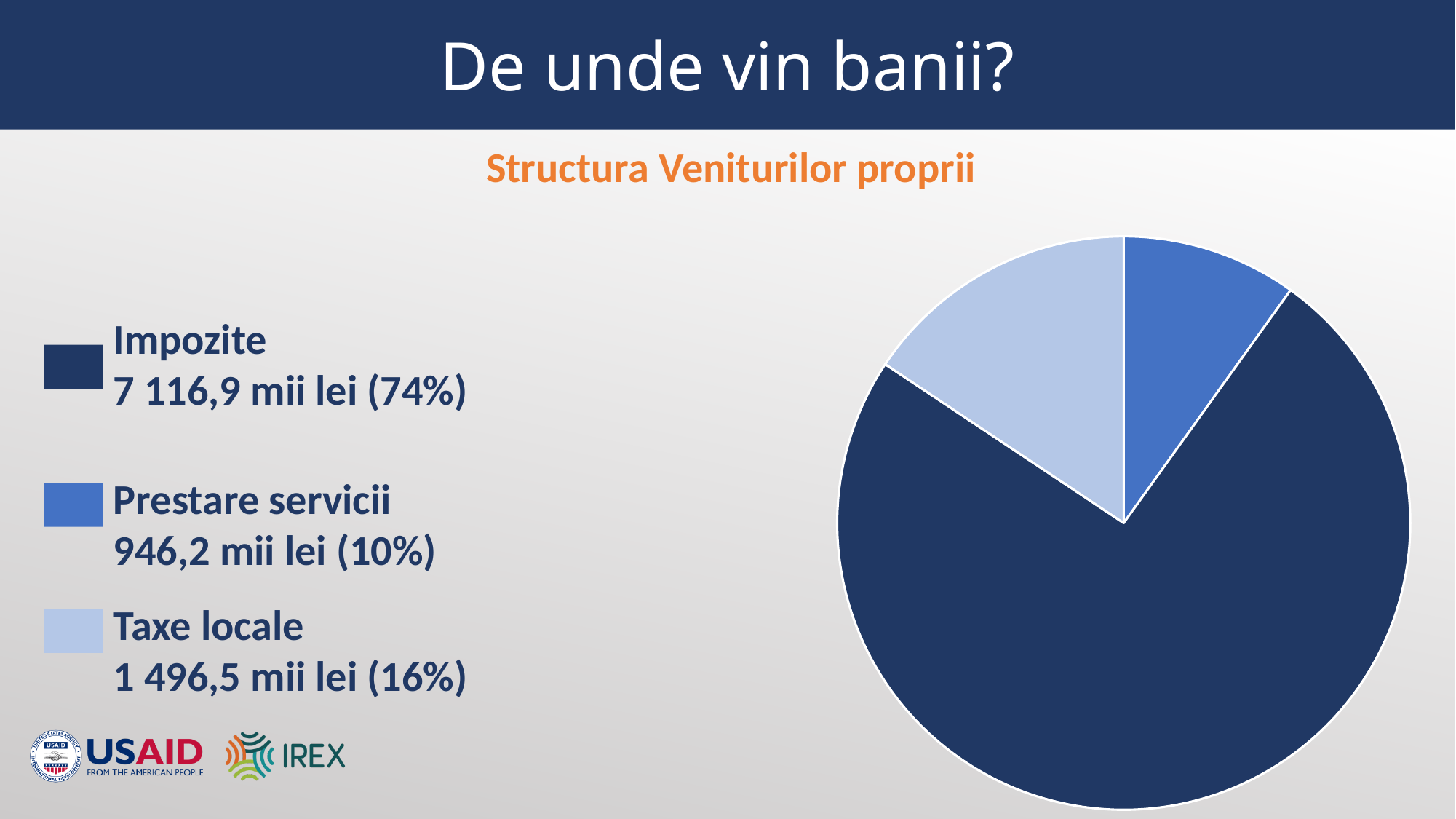
Which category has the smallest slice of the pie? Prestare servicii What share of the pie does Impozite represent? 74% How many categories does the pie chart have? 3 What share of the pie does Prestare servicii represent? 10% What is the value for Impozite? 7 116,9 mii lei Which category has the largest slice of the pie? Impozite What is the value for Prestare servicii? 946,2 mii lei What is the title of the chart? Structura Veniturilor proprii Which is larger, Taxe locale or Prestare servicii? Taxe locale What share of the pie does Taxe locale represent? 16% What is the value for Taxe locale? 1 496,5 mii lei What kind of chart is shown on the slide? pie chart